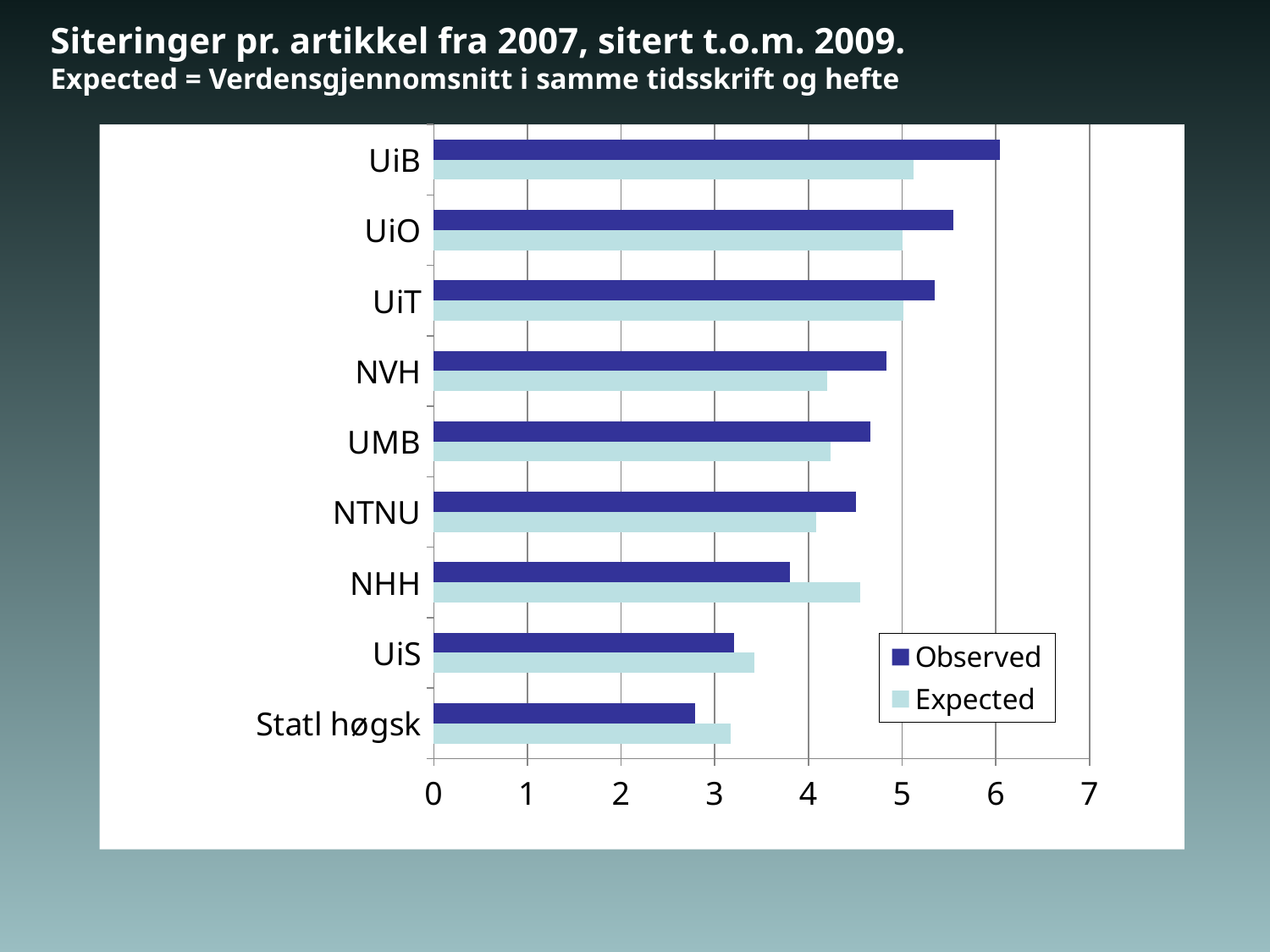
What kind of chart is shown on the slide? bar chart Is the Observed value for Statl høgsk greater or less than 3? less For NHH, which is larger, the Observed or the Expected value? Expected Is the Expected value for NHH greater or less than 4? greater How many series does the legend list? 2 For UiB, which is larger, the Observed or the Expected value? Observed What are the two series named in the legend? Observed and Expected Is the Observed value for NHH greater or less than 4? less How many institutions are listed on the chart? 9 Which institution has the lowest Observed value? Statl høgsk Which institution has the highest Observed value? UiB